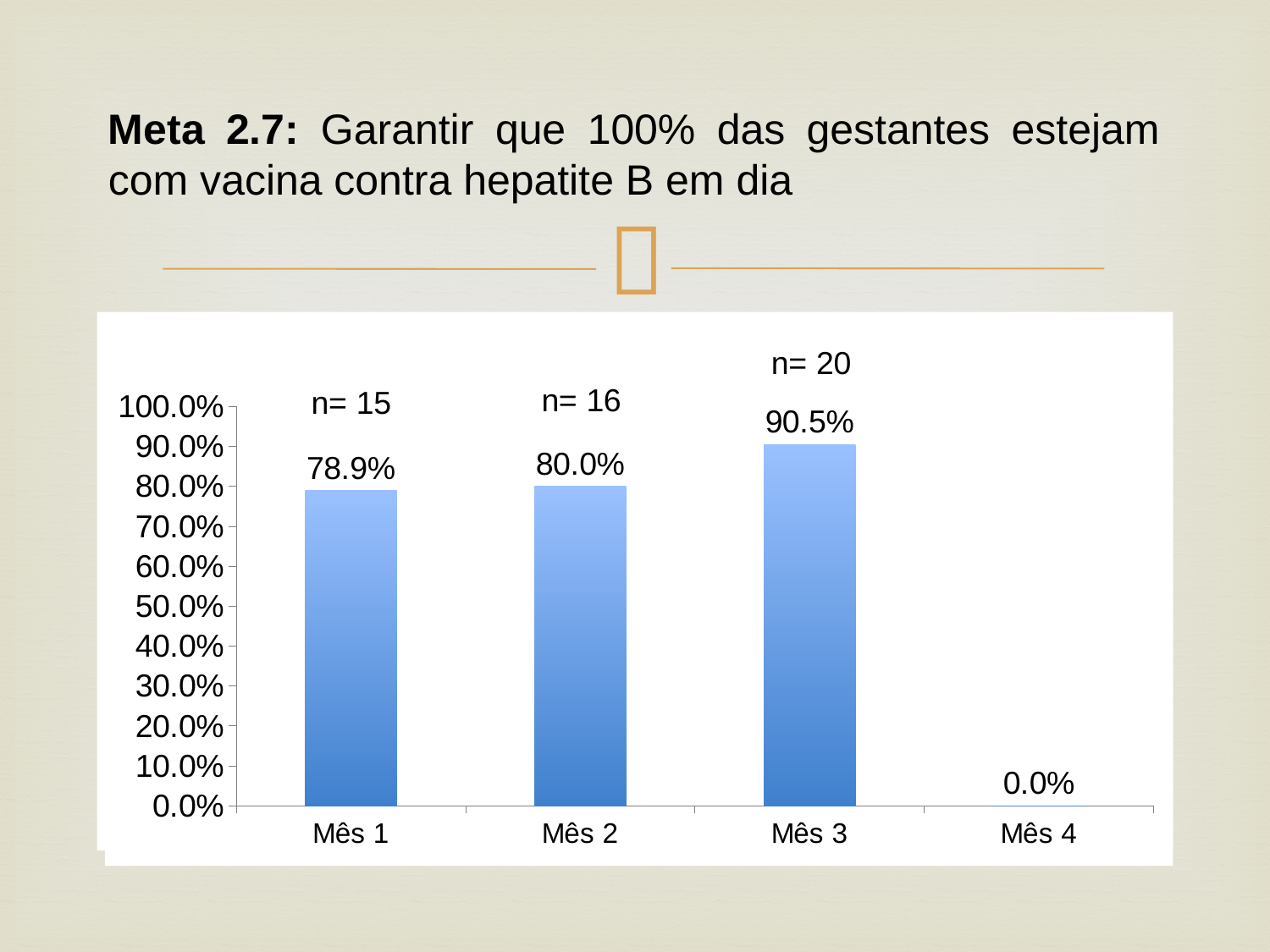
What is the value for Mês 4? 0.0% What is the difference between the values for Mês 3 and Mês 2? 10.5% What kind of chart is shown on the slide? bar chart How many months are shown on the x axis? 4 Which month has the lowest value? Mês 4 Which is larger, the value for Mês 1 or the value for Mês 2? Mês 2 What is the n value shown above the bar for Mês 3? n= 20 What is the value for Mês 3? 90.5% Do the values rise or fall from Mês 1 to Mês 3? rise Is the value for Mês 3 greater or less than 90.0%? greater What is the value for Mês 1? 78.9% Which month has the highest value? Mês 3